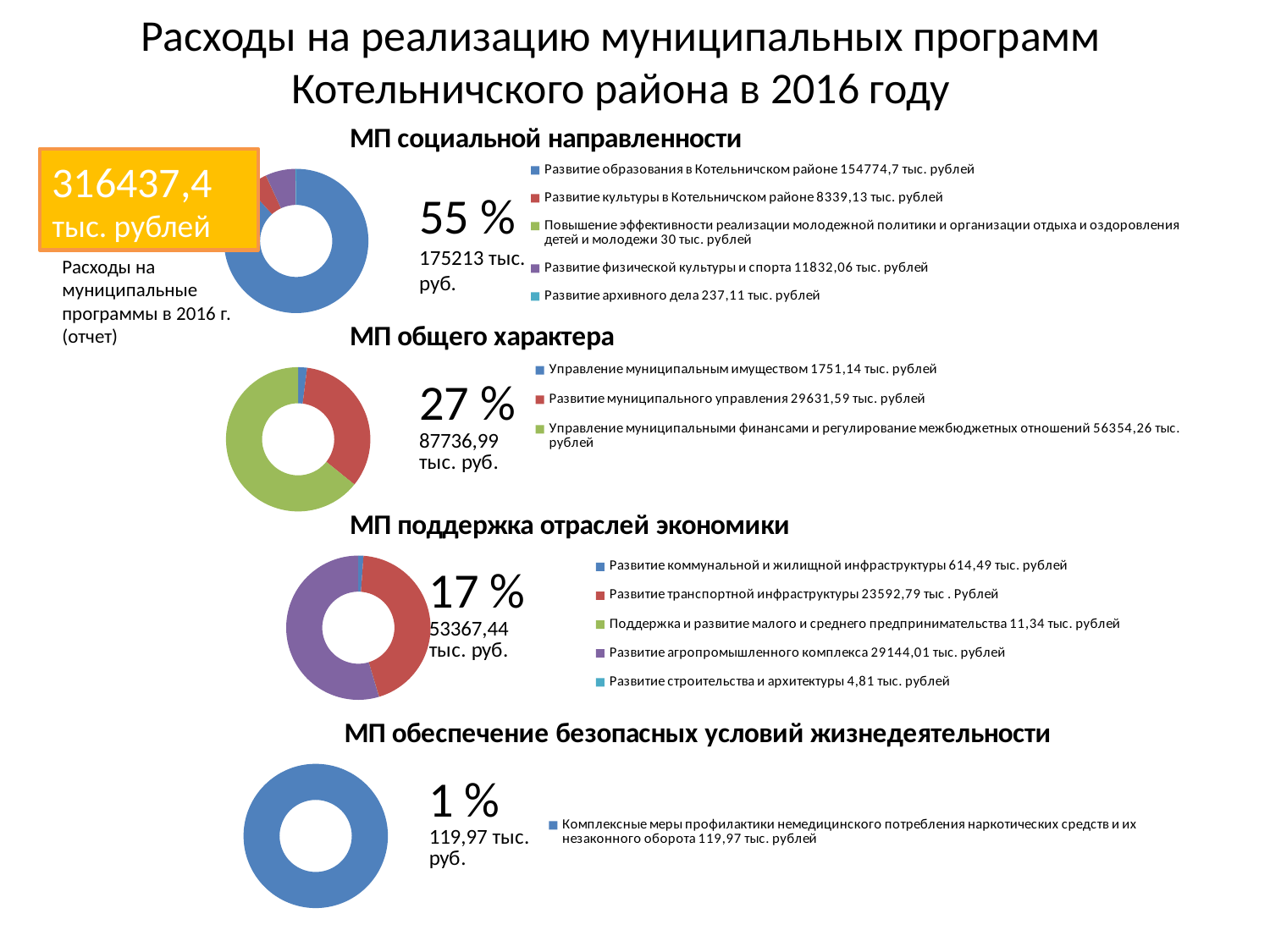
In the "МП обеспечение безопасных условий жизнедеятельности" chart, what is the value of the single category? 119,97 тыс. рублей In the "МП социальной направленности" chart, which category has the smallest value? Повышение эффективности реализации молодежной политики и организации отдыха и оздоровления детей и молодежи (30 тыс. рублей) In the "МП общего характера" chart, which category has the largest value? Управление муниципальными финансами и регулирование межбюджетных отношений (56354,26 тыс. рублей) In the "МП социальной направленности" chart, what is the value for "Развитие образования в Котельничском районе"? 154774,7 тыс. рублей In the "МП поддержка отраслей экономики" chart, which is larger: "Развитие агропромышленного комплекса" or "Развитие транспортной инфраструктуры"? Развитие агропромышленного комплекса What total amount is shown in the orange box on the left of the slide? 316437,4 тыс. рублей What percentage share is shown next to the "МП общего характера" chart? 27 % In the "МП социальной направленности" chart, how many categories does the legend list? 5 In the "МП поддержка отраслей экономики" chart, what is the value for "Развитие строительства и архитектуры"? 4,81 тыс. рублей What kind of chart is used for "МП социальной направленности"? Doughnut (pie) chart In the "МП общего характера" chart, what is the difference between "Развитие муниципального управления" and "Управление муниципальным имуществом"? 27880,45 тыс. рублей In the "МП поддержка отраслей экономики" chart, how many categories are shown in the legend? 5